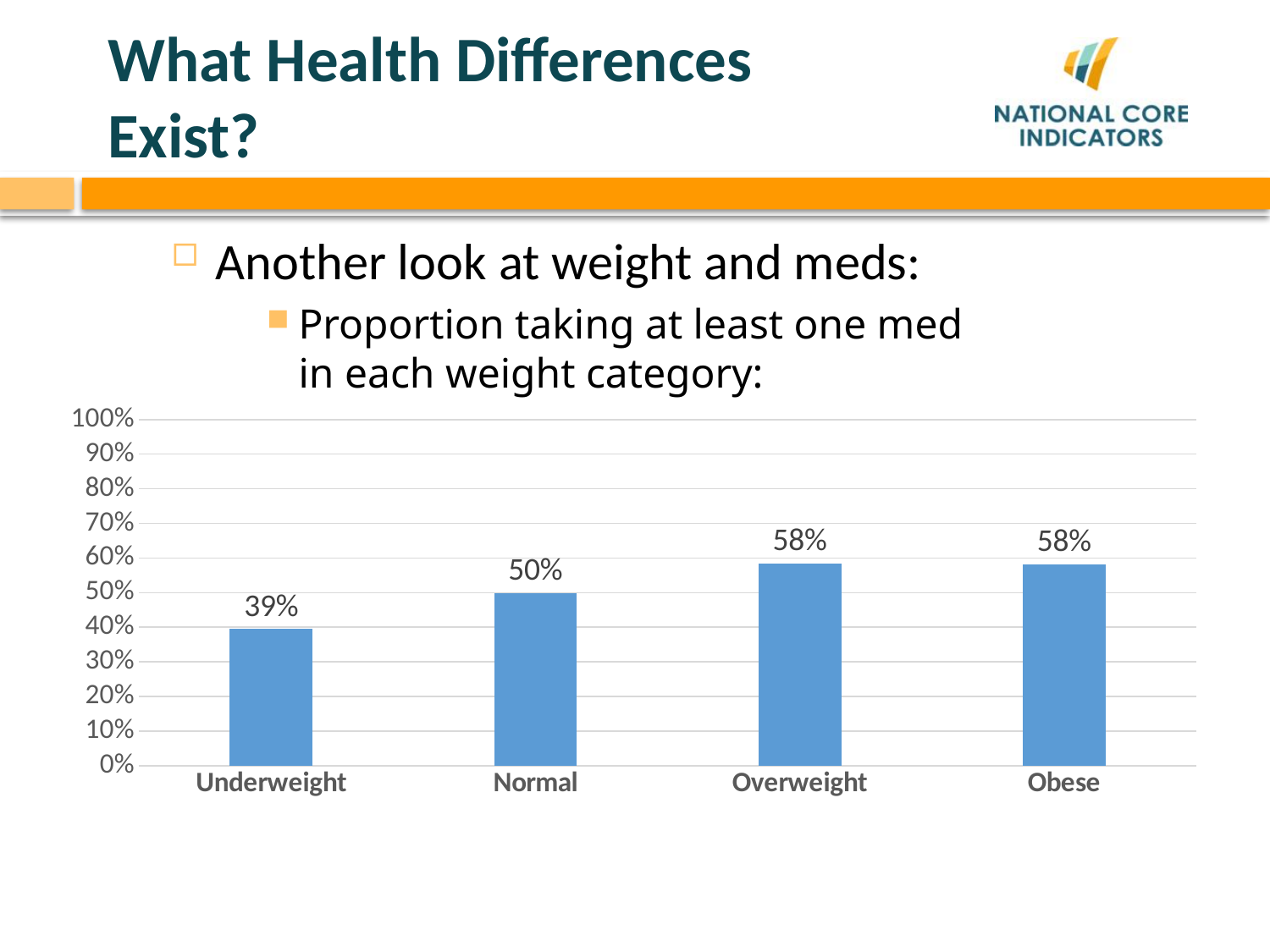
Which is larger, the value for Normal or the value for Obese? Obese What kind of chart is shown on the slide? Bar chart What is the difference between the Normal and Underweight values? 11% What is the value shown for the Overweight category? 58% What proportion of the Underweight category is taking at least one med? 39% What is the difference between the Overweight and Underweight values? 19% What is the highest value shown on the vertical axis? 100% How many weight categories are shown on the chart? 4 What is the value shown for the Normal weight category? 50% What is the value shown for the Obese category? 58% Is the value for Underweight greater or less than 40%? less Which weight category has the lowest proportion taking at least one med? Underweight